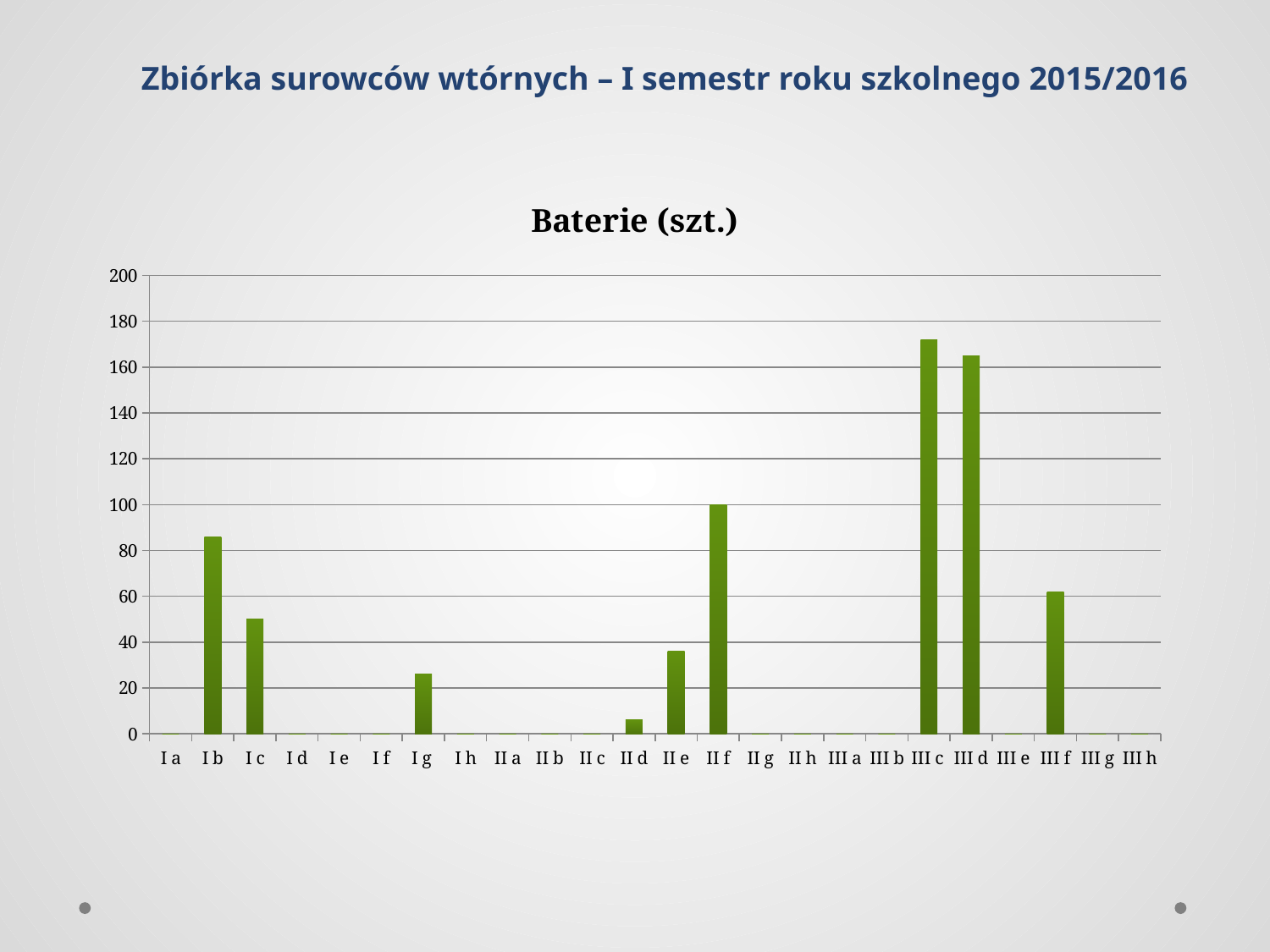
Is the value for III c greater or less than 160? greater Which is larger, the value for I b or the value for I c? I b Is the value for III d greater or less than 180? less How many categories are shown on the x axis of the chart? 24 What kind of chart is shown on the slide? bar chart What is the value for II f? 100 Is the value for I g greater or less than 40? less Which category has the highest value? III c What is the title of the chart? Baterie (szt.) Which is larger, the value for II f or the value for III f? II f